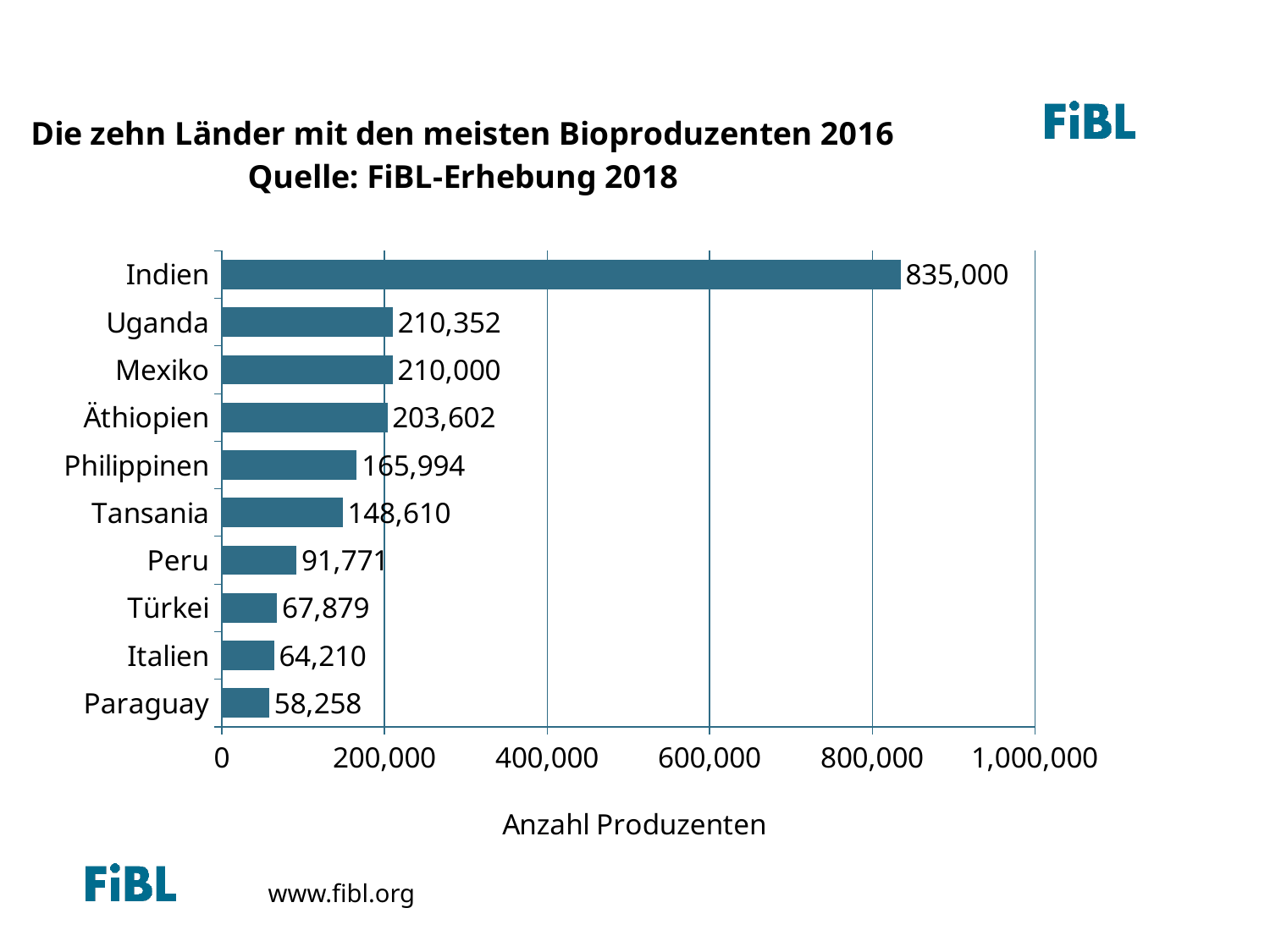
What is the value shown for Tansania? 148,610 What is the difference between the values for Indien and Uganda? 624,648 What kind of chart is shown on the slide? bar chart Which country has the lowest number of producers? Paraguay Which has more producers, Peru or Italien? Peru How many producers does Indien have according to the chart? 835,000 What is the number of producers for Türkei? 67,879 What is the label of the horizontal axis? Anzahl Produzenten Is the value for Philippinen greater or less than 200,000? less What is the difference between the values for Peru and Türkei? 23,892 Which country has the highest number of producers? Indien How many countries are shown in the chart? 10